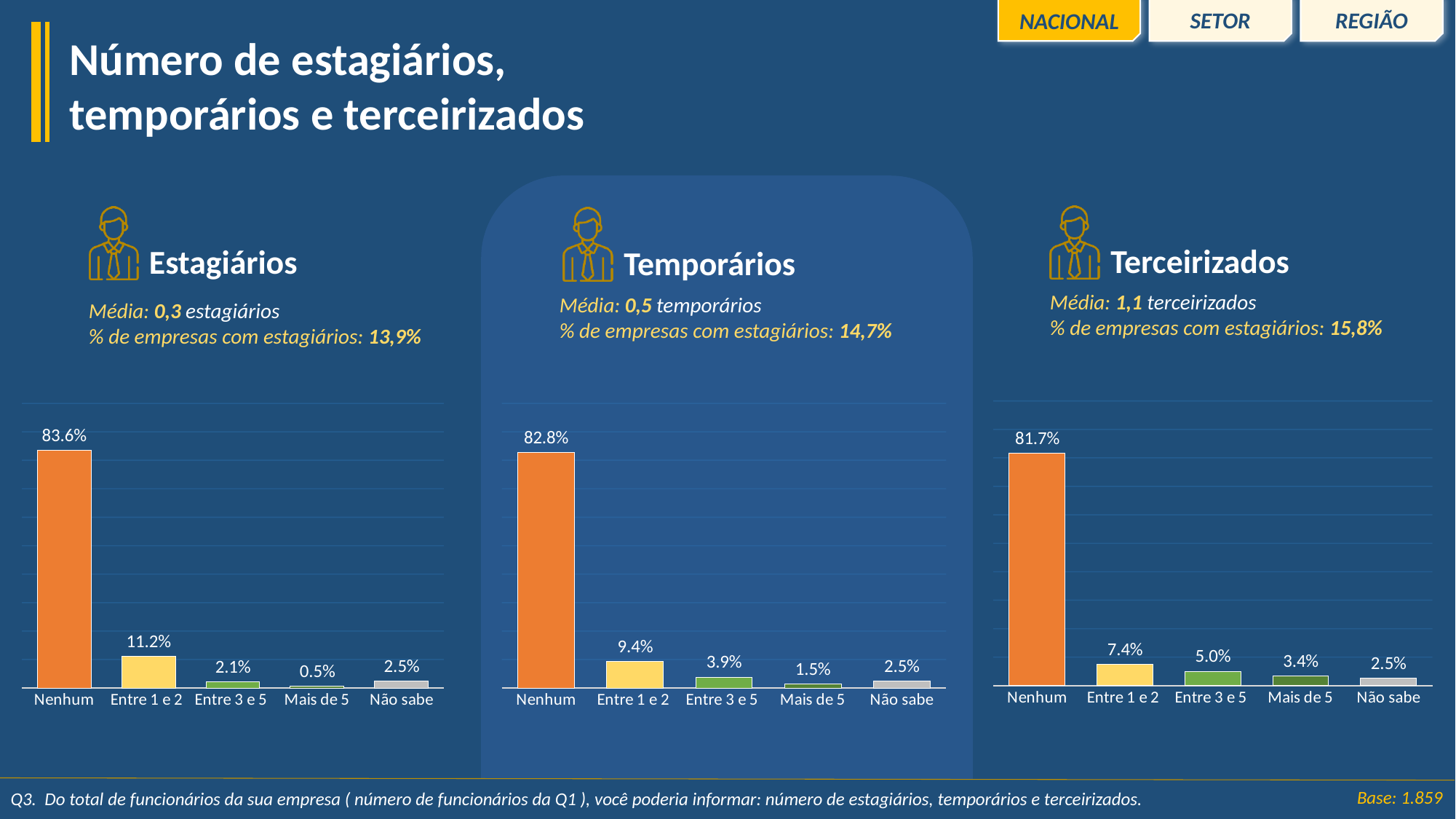
In the Terceirizados chart, what is the value for Entre 3 e 5? 5.0% In the Temporários chart, what is the value for Mais de 5? 1.5% In the Terceirizados chart, which category has the highest value? Nenhum What kind of chart is the Temporários chart? Bar chart In the Estagiários chart, which category has the lowest value? Mais de 5 In the Estagiários chart, what is the difference between Nenhum and Entre 1 e 2? 72.4% In the Terceirizados chart, which is larger: Mais de 5 or Não sabe? Mais de 5 In the Estagiários chart, what is the value for Nenhum? 83.6% How many charts are on the slide? 3 In the Temporários chart, what is the value for Entre 1 e 2? 9.4% In the Estagiários chart, how many categories are shown? 5 In the Temporários chart, what is the difference between Entre 1 e 2 and Entre 3 e 5? 5.5%